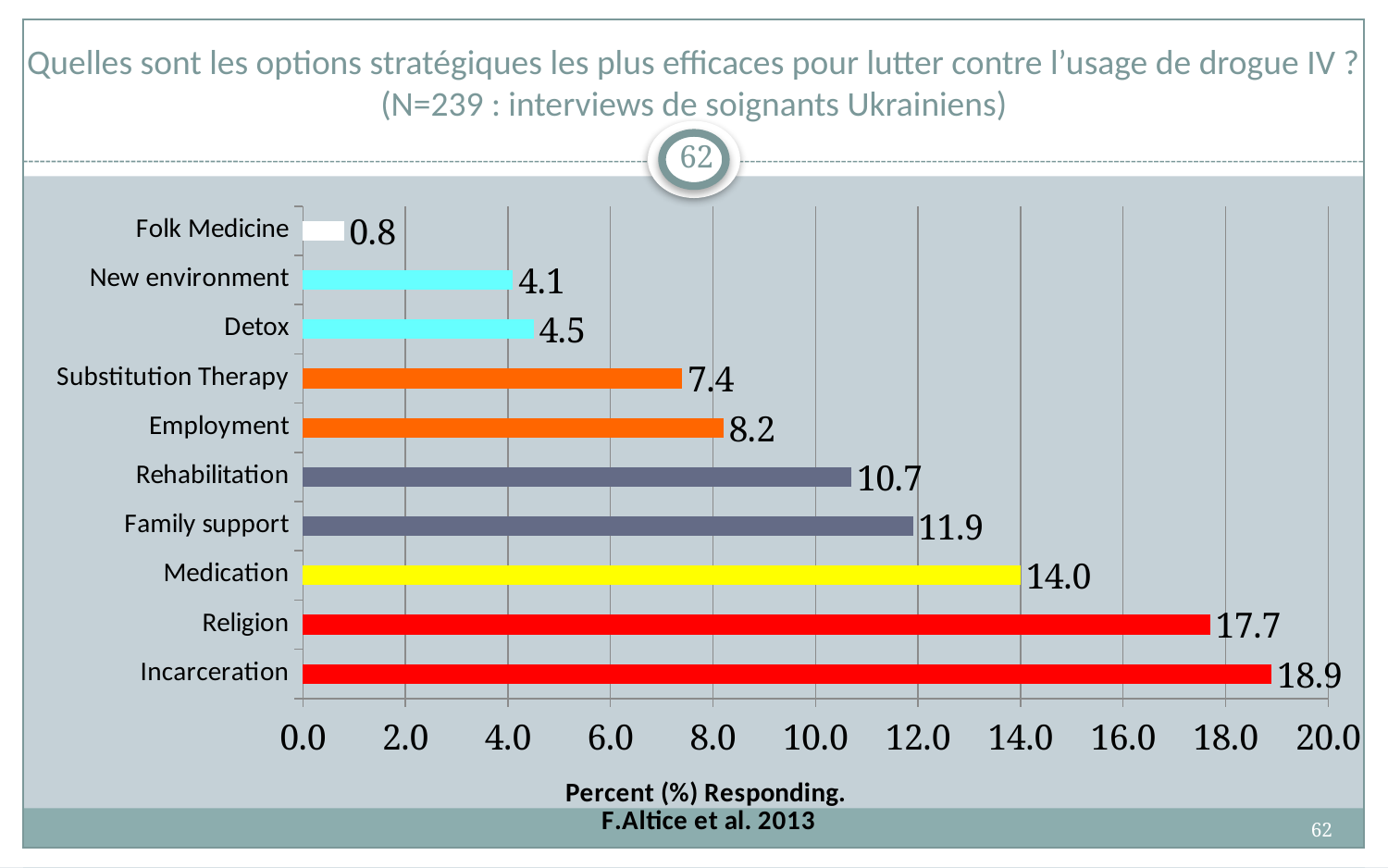
How many categories are shown in the chart? 10 What is the value for Substitution Therapy? 7.4 Which category has the lowest value? Folk Medicine What is the value for Incarceration? 18.9 What is the value for Medication? 14.0 What is the value for Folk Medicine? 0.8 Which is larger, the value for Employment or the value for Detox? Employment What is the difference between the values for Family support and Rehabilitation? 1.2 What kind of chart is shown on the slide? Bar chart What is the difference between the values for Religion and Medication? 3.7 What is the label of the horizontal axis? Percent (%) Responding. Which category has the highest value? Incarceration